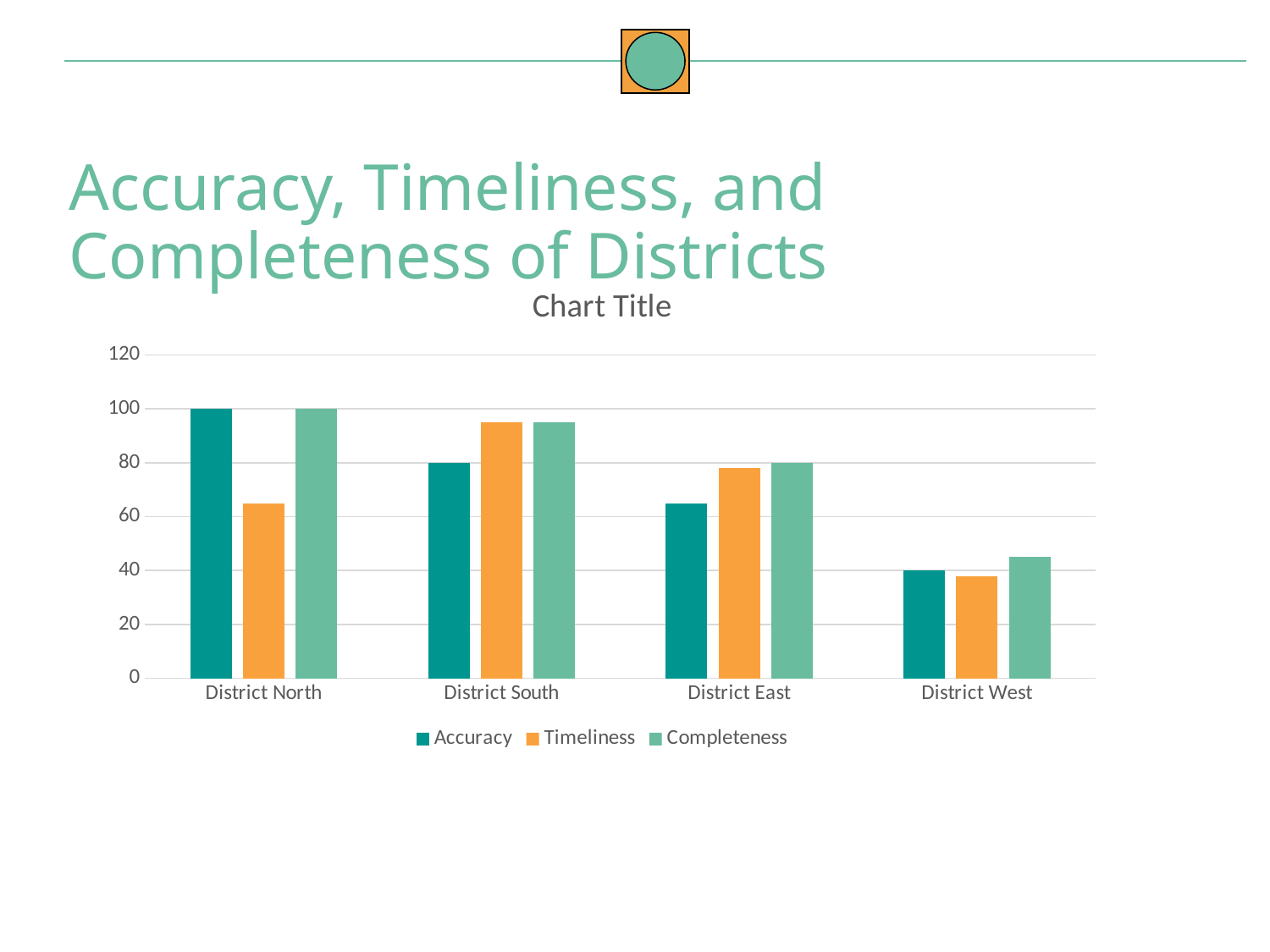
Is the Timeliness value for District North greater or less than 60? greater Is the Completeness value for District West greater or less than 60? less What is the Accuracy value for District South? 80 How many series does the legend list? 3 What kind of chart is shown on the slide? bar chart What is the Completeness value for District East? 80 How many districts are shown on the x axis? 4 What is the Accuracy value for District North? 100 What is the Accuracy value for District West? 40 Which district has the highest Accuracy value? District North Which is larger for District South, Accuracy or Timeliness? Timeliness Which district has the lowest Timeliness value? District West